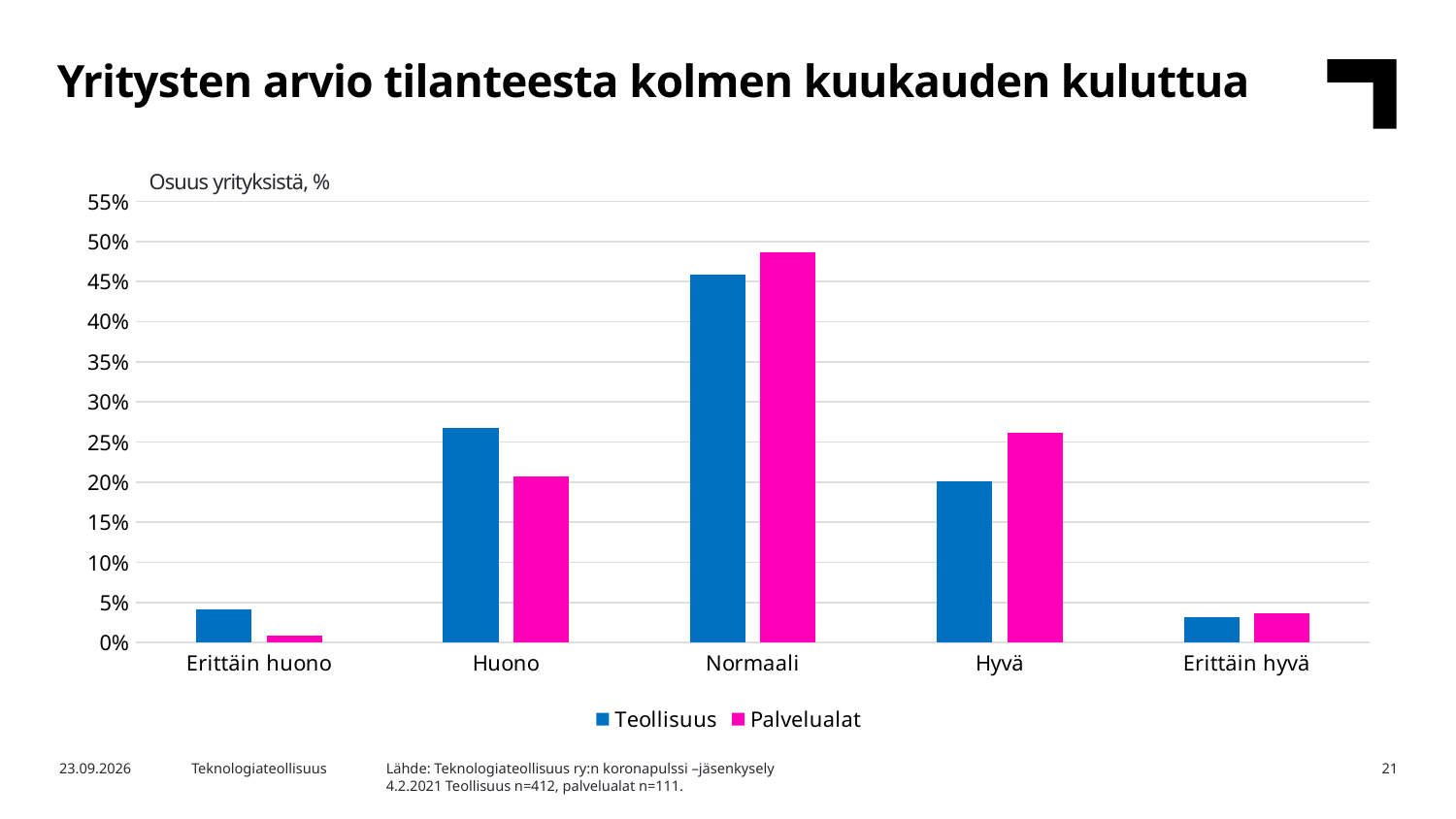
How many categories are shown on the x axis? 5 What kind of chart is shown on the slide? Bar chart Is the value for Teollisuus in the Normaali category greater or less than 40%? greater How many series does the legend list? 2 Is the value for Palvelualat in the Huono category greater or less than 25%? less Which category has the highest value for Teollisuus? Normaali Is the value for Palvelualat in the Normaali category greater or less than 45%? greater What label is shown above the vertical axis of the chart? Osuus yrityksistä, % In the Hyvä category, which series has the larger value, Teollisuus or Palvelualat? Palvelualat In the Huono category, which series has the larger value, Teollisuus or Palvelualat? Teollisuus Which category has the lowest value for Palvelualat? Erittäin huono What is the title of the chart on the slide? Yritysten arvio tilanteesta kolmen kuukauden kuluttua